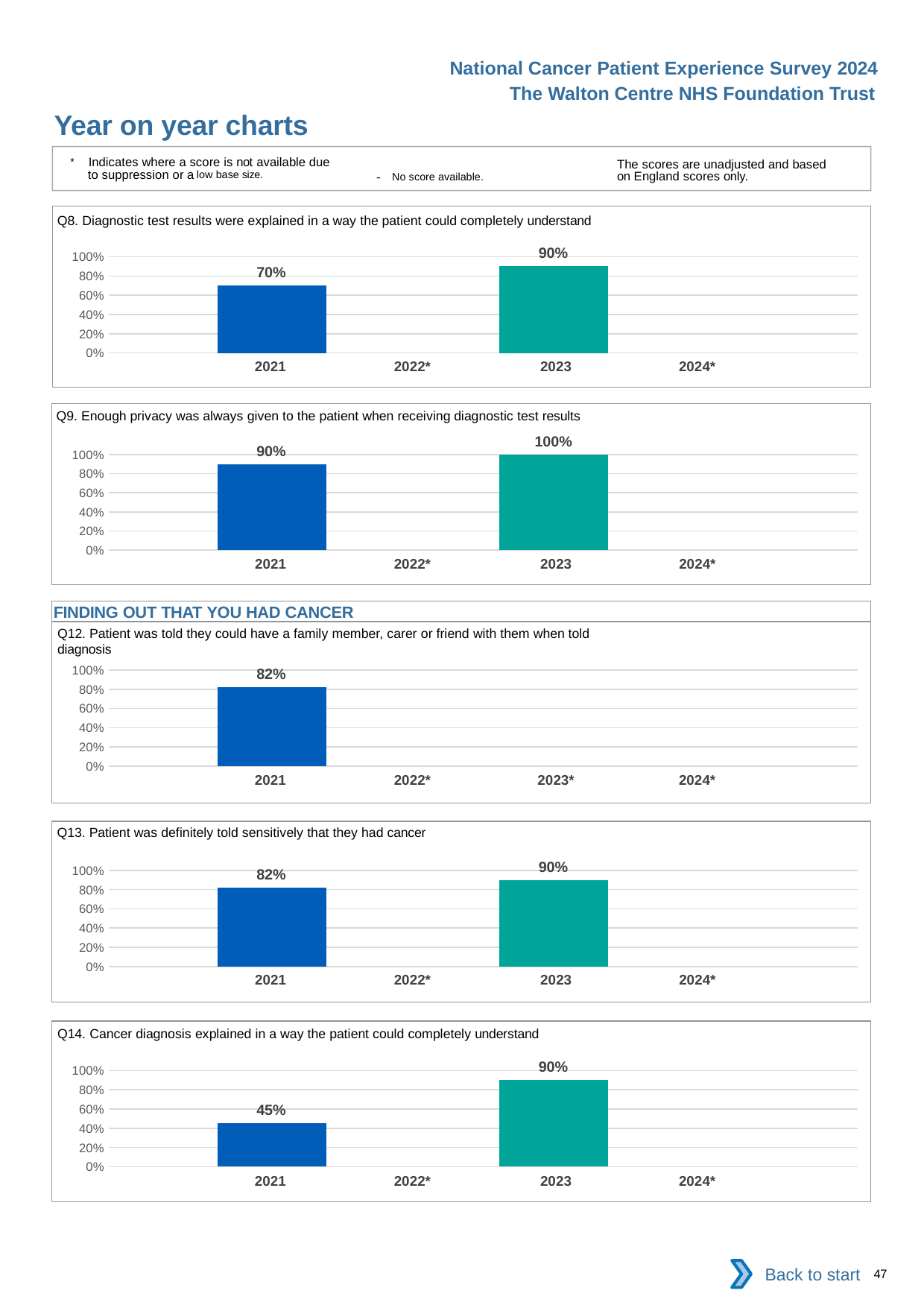
What type of chart is the Q14 chart? Bar chart In the Q14 chart (Cancer diagnosis explained in a way the patient could completely understand), what is the value for 2021? 45% In the Q12 chart, how many years have a bar plotted? 1 In the Q8 chart (Diagnostic test results were explained in a way the patient could completely understand), what is the value for 2021? 70% In the Q8 chart, what is the value for 2023? 90% In the Q9 chart, which year has the higher value, 2021 or 2023? 2023 In the Q12 chart (Patient was told they could have a family member, carer or friend with them when told diagnosis), what is the value for 2021? 82% In the Q8 chart, what is the difference between the 2023 and 2021 values? 20 percentage points In the Q13 chart (Patient was definitely told sensitively that they had cancer), what is the value for 2023? 90% In the Q9 chart (Enough privacy was always given to the patient when receiving diagnostic test results), what is the value for 2023? 100% In the Q14 chart, which year has the lowest value? 2021 In the Q13 chart, what is the difference between the 2023 and 2021 values? 8 percentage points